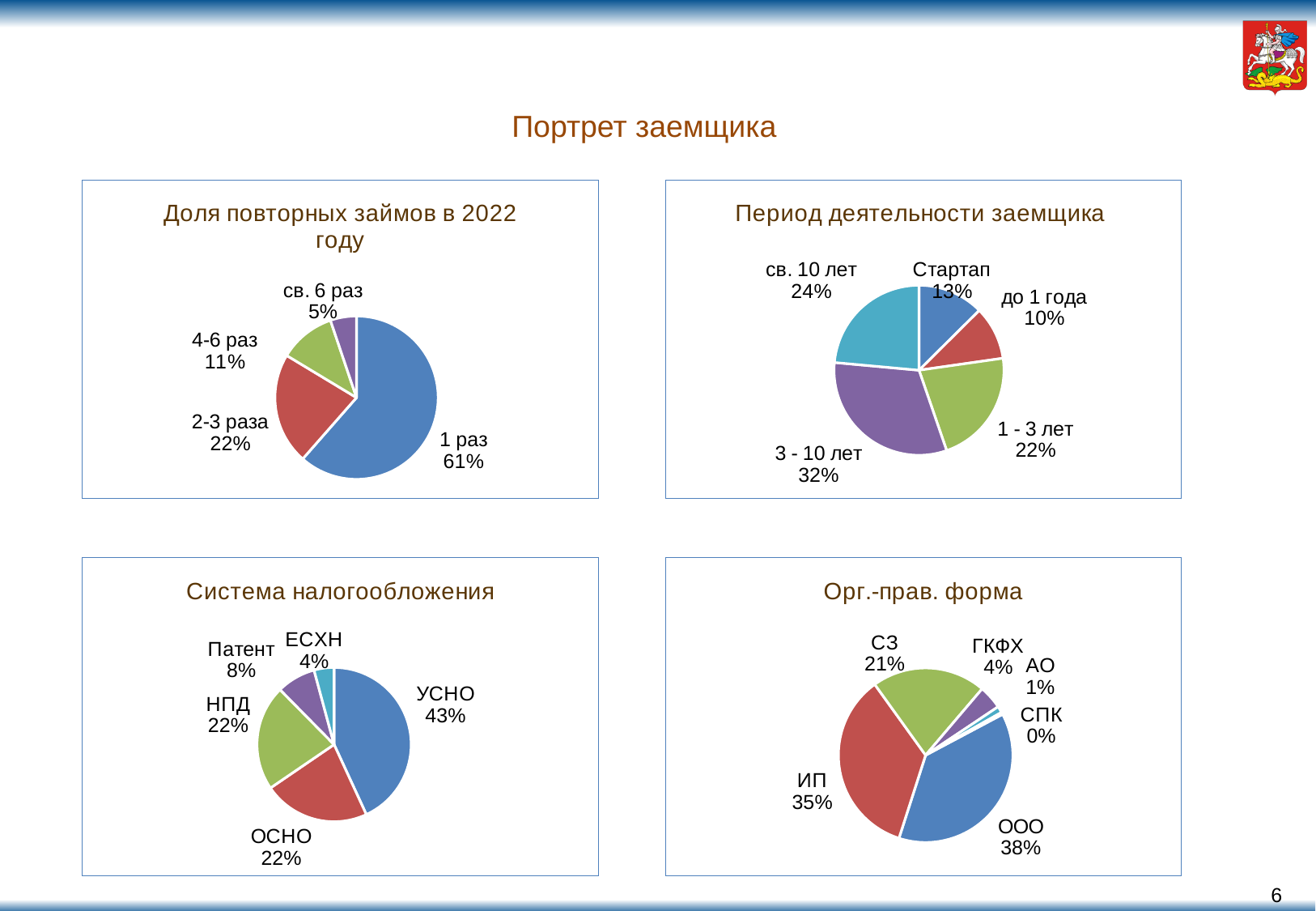
In the chart "Доля повторных займов в 2022 году", what share is labelled for "1 раз"? 61% In the chart "Система налогообложения", which is larger, the share for "Патент" or the share for "ЕСХН"? Патент In the chart "Доля повторных займов в 2022 году", how many slices does the pie have? 4 In the chart "Орг.-прав. форма", which category has the largest share? ООО In the chart "Орг.-прав. форма", what share is labelled for "ИП"? 35% In the chart "Период деятельности заемщика", what is the difference between the shares for "св. 10 лет" and "до 1 года"? 14% In the chart "Период деятельности заемщика", which category has the largest share? 3 - 10 лет In the chart "Система налогообложения", how many categories are shown? 5 In the chart "Период деятельности заемщика", what share is labelled for "3 - 10 лет"? 32% What kind of chart is used in the chart "Орг.-прав. форма"? Pie chart In the chart "Доля повторных займов в 2022 году", which category has the smallest share? св. 6 раз In the chart "Система налогообложения", what share is labelled for "УСНО"? 43%